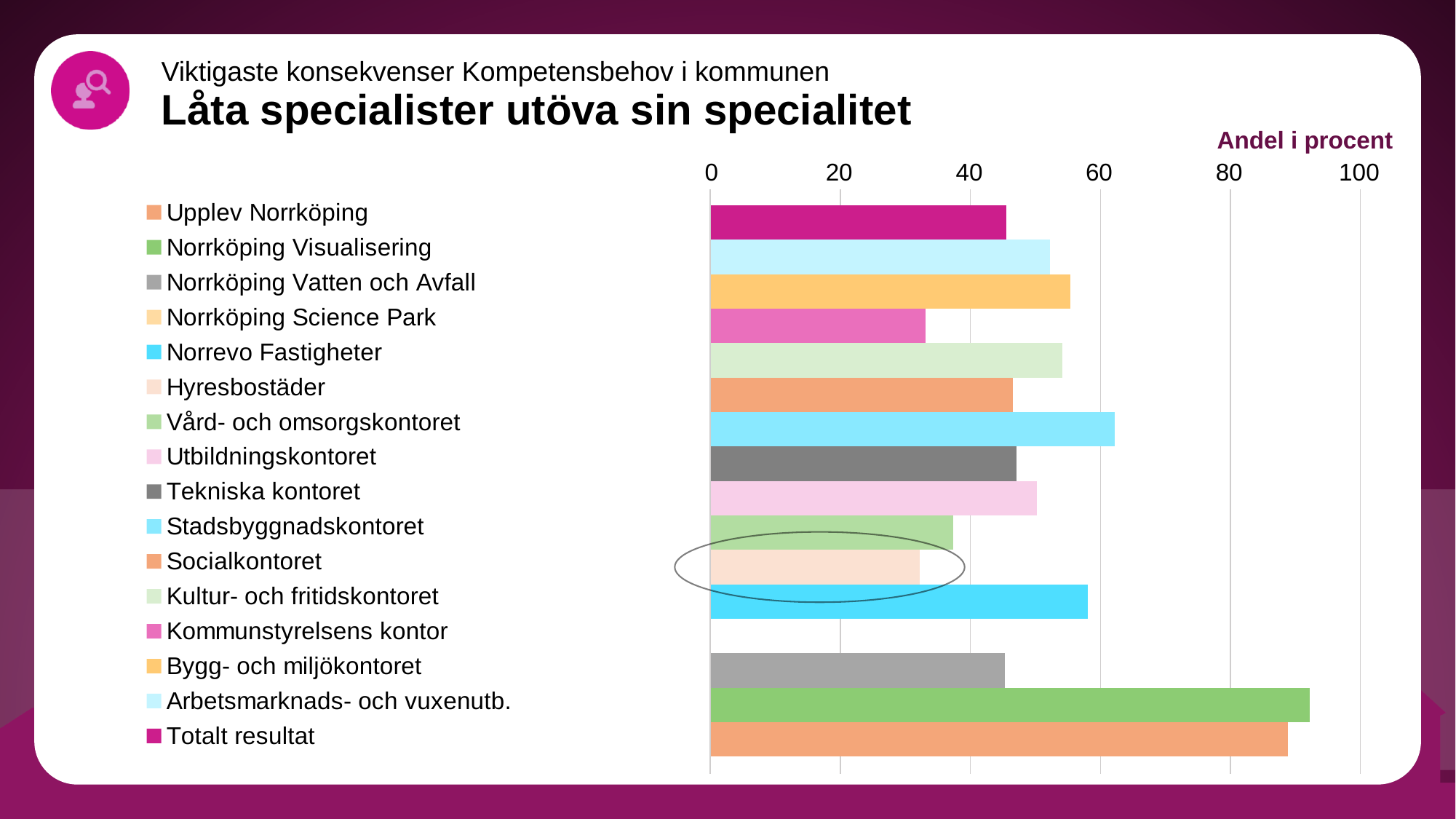
Which is larger, the value for Stadsbyggnadskontoret or the value for Tekniska kontoret? Stadsbyggnadskontoret Is the value for Kommunstyrelsens kontor greater or less than 40? less Which category's bar is circled on the chart? Hyresbostäder What kind of chart is shown on the slide? bar chart Which is larger, the value for Norrevo Fastigheter or the value for Hyresbostäder? Norrevo Fastigheter Is the value for Bygg- och miljökontoret greater or less than 60? less Is the value for Totalt resultat greater or less than 40? greater How many categories does the legend list? 16 What is the label shown above the horizontal axis? Andel i procent Which category has the lowest value (no visible bar)? Norrköping Science Park